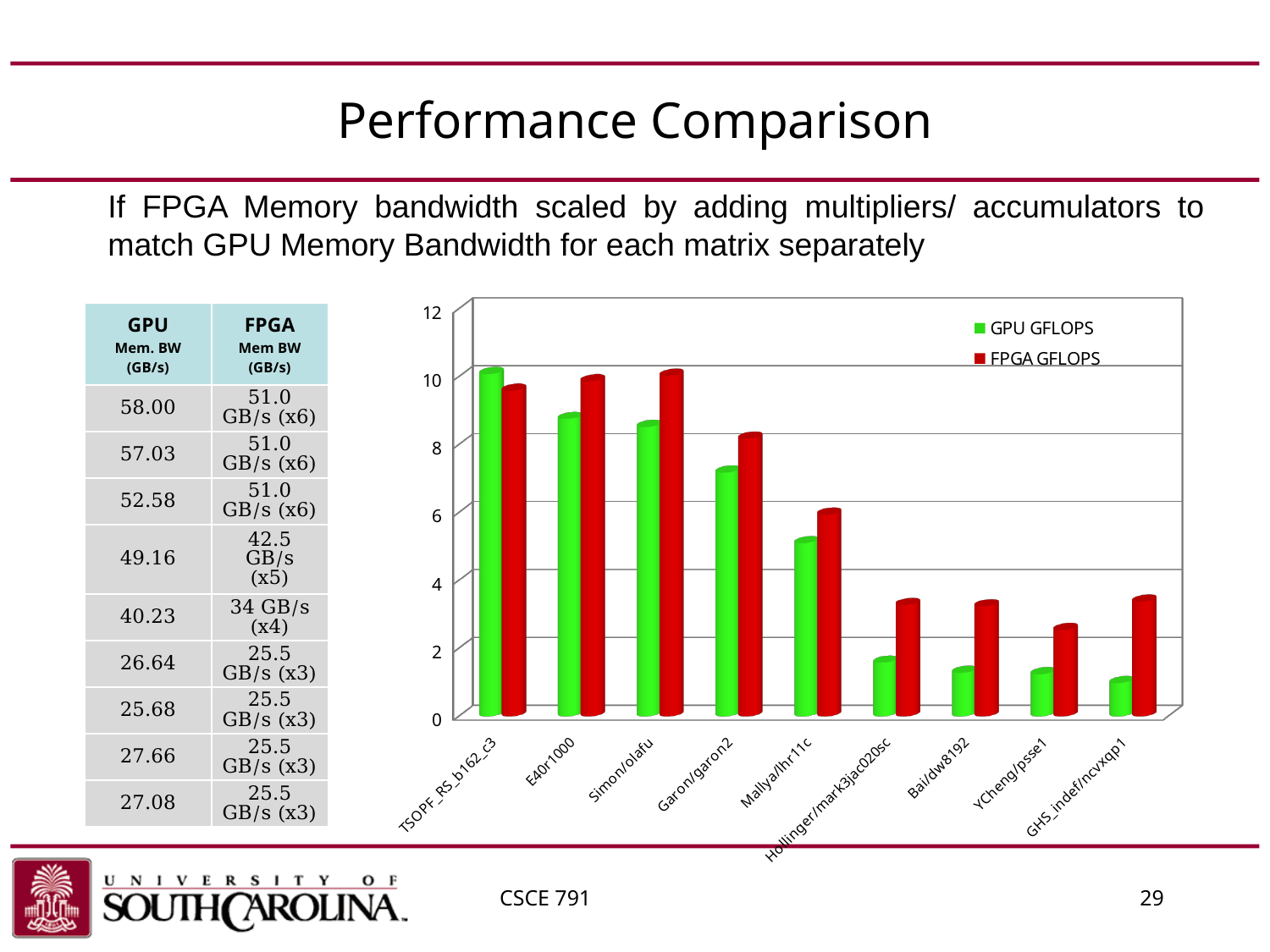
Which matrix has the lowest GPU GFLOPS value in the chart? GHS_indef/ncvxqp1 Is the GPU GFLOPS value for Garon/garon2 greater or less than 8? less How many series does the chart legend list? 2 For Hollinger/mark3jac020sc, which is larger: GPU GFLOPS or FPGA GFLOPS? FPGA GFLOPS For TSOPF_RS_b162_c3, which is larger: GPU GFLOPS or FPGA GFLOPS? GPU GFLOPS Is the FPGA GFLOPS value for Bai/dw8192 greater or less than 2? greater What type of chart is shown on the slide? bar chart Which series is shown in green in the chart? GPU GFLOPS How many matrices (categories) are plotted along the x axis of the chart? 9 Do the GPU GFLOPS values generally rise or fall moving left to right along the x axis? fall Which matrix has the highest GPU GFLOPS value in the chart? TSOPF_RS_b162_c3